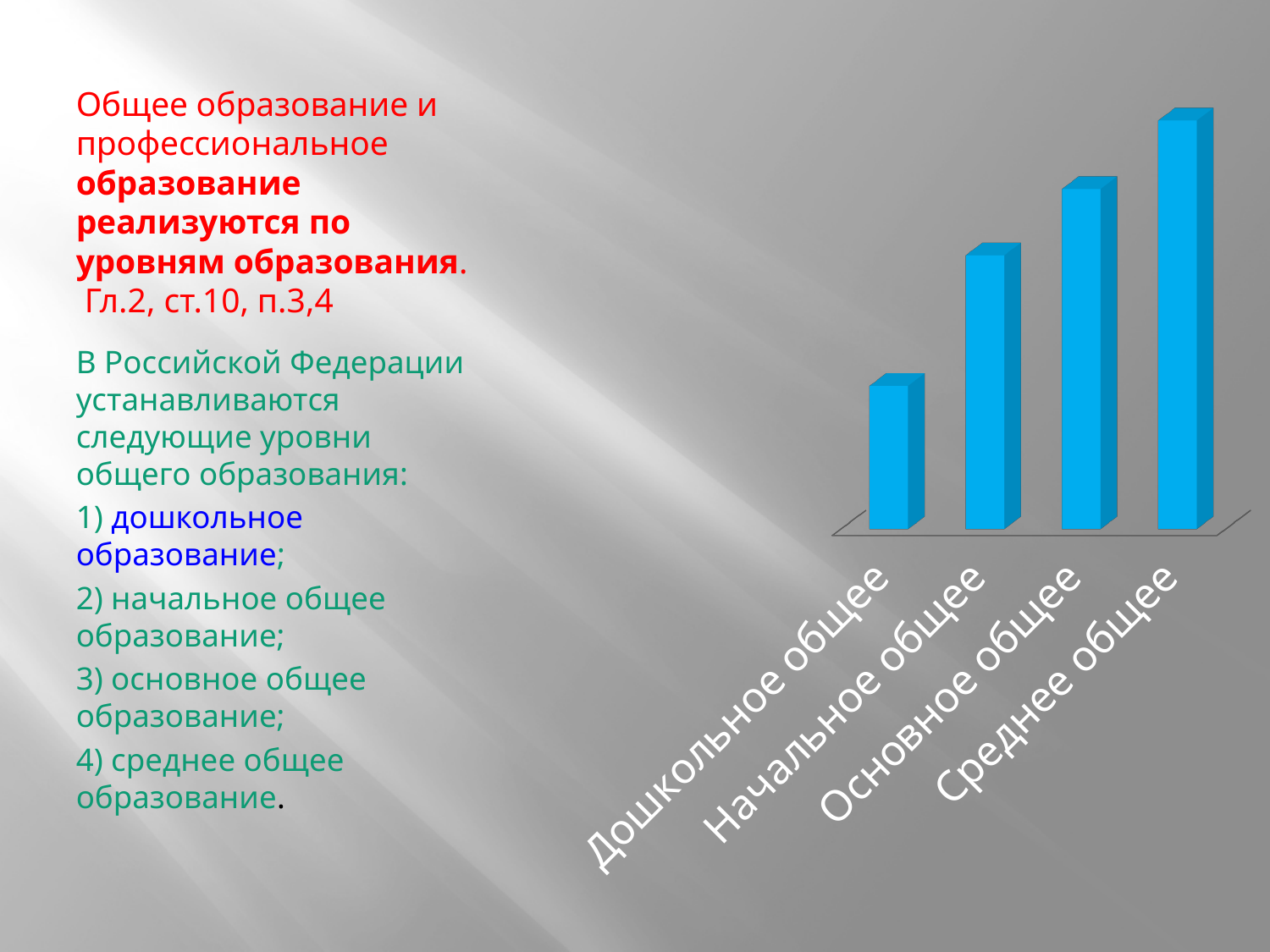
What is the label of the first category on the x axis? Дошкольное общее What colour are the bars in the chart? blue Which is larger, the bar for Начальное общее or the bar for Основное общее? Основное общее Which category has the highest bar? Среднее общее What kind of chart is shown on the slide? bar chart Which category has the lowest bar? Дошкольное общее Which is larger, the bar for Дошкольное общее or the bar for Среднее общее? Среднее общее How many categories does the chart show? 4 Do the bars rise or fall from left to right along the x axis? rise